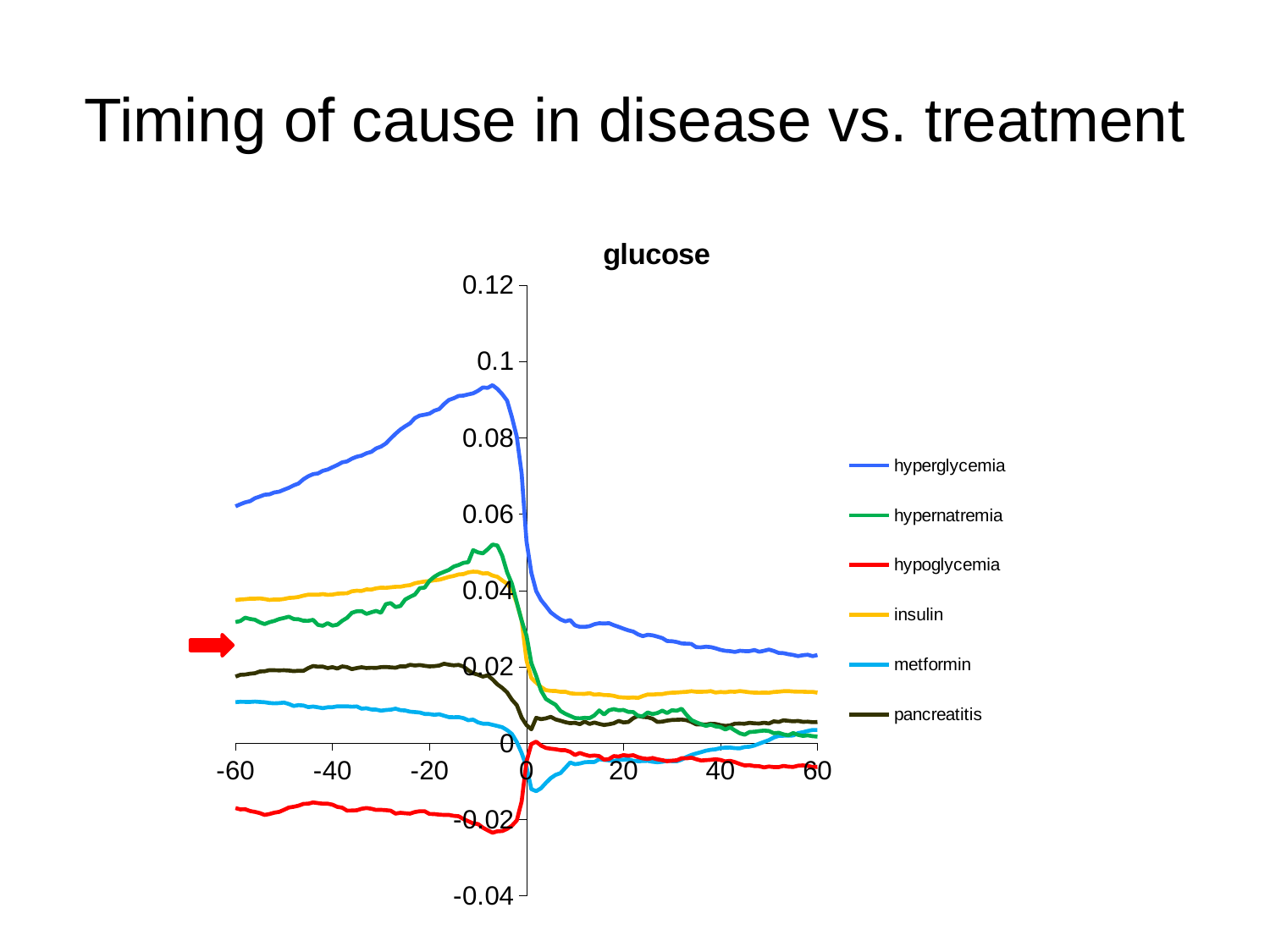
At x = -60, which is larger, the hypernatremia value or the pancreatitis value? hypernatremia Which series has the highest value at x = -60? hyperglycemia What is the title of the chart? glucose What kind of chart is shown on the slide? line chart Is the value of the metformin line at x = -60 greater or less than 0.02? less Is the peak value of the hyperglycemia line greater or less than 0.08? greater Is the value of the hyperglycemia line at x = 60 greater or less than 0.04? less Which series has the lowest value at x = -60? hypoglycemia Does the hyperglycemia line rise or fall between x = -60 and x = -10? rise How many series does the legend of the glucose chart list? 6 What colour is the hypoglycemia line in the legend? red